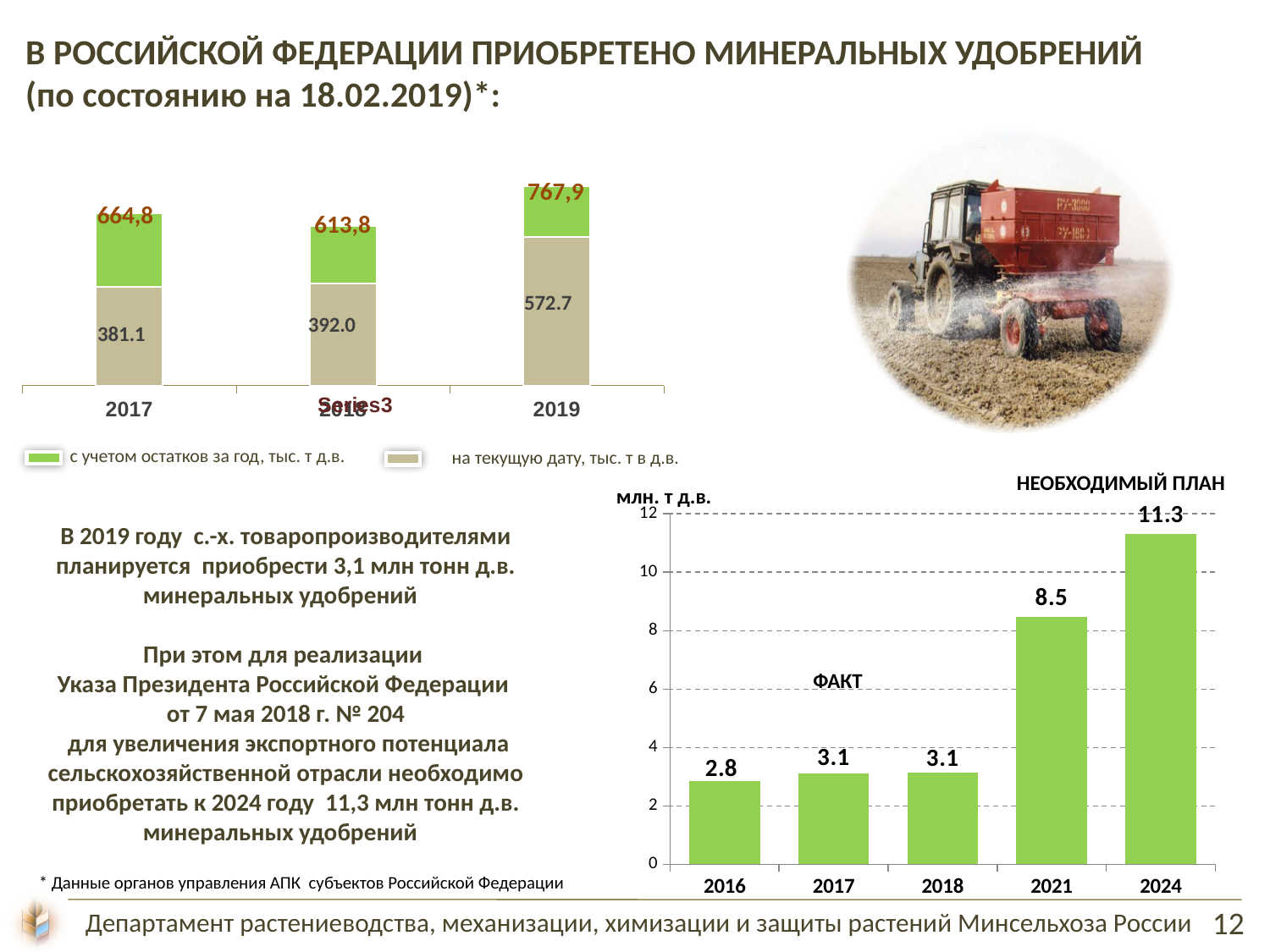
In the top-left chart, what is the value of the beige (на текущую дату) segment for 2017? 381.1 In the bottom-right chart, what is the value for 2021? 8.5 In the bottom-right chart, do the values rise or fall from 2016 to 2024? rise In the bottom-right chart, what is the value for 2024? 11.3 In the bottom-right chart, what is the value for 2016? 2.8 In the top-left chart, which year has the larger beige (на текущую дату) value, 2017 or 2019? 2019 In the bottom-right chart, which year has the highest value? 2024 In the bottom-right chart, which year has the lowest value? 2016 In the bottom-right chart, how many years are shown on the x axis? 5 What type of chart is the bottom-right chart? bar chart In the top-left chart, what is the value of the beige (на текущую дату) segment for 2019? 572.7 In the bottom-right chart, what is the difference between the values for 2024 and 2021? 2.8